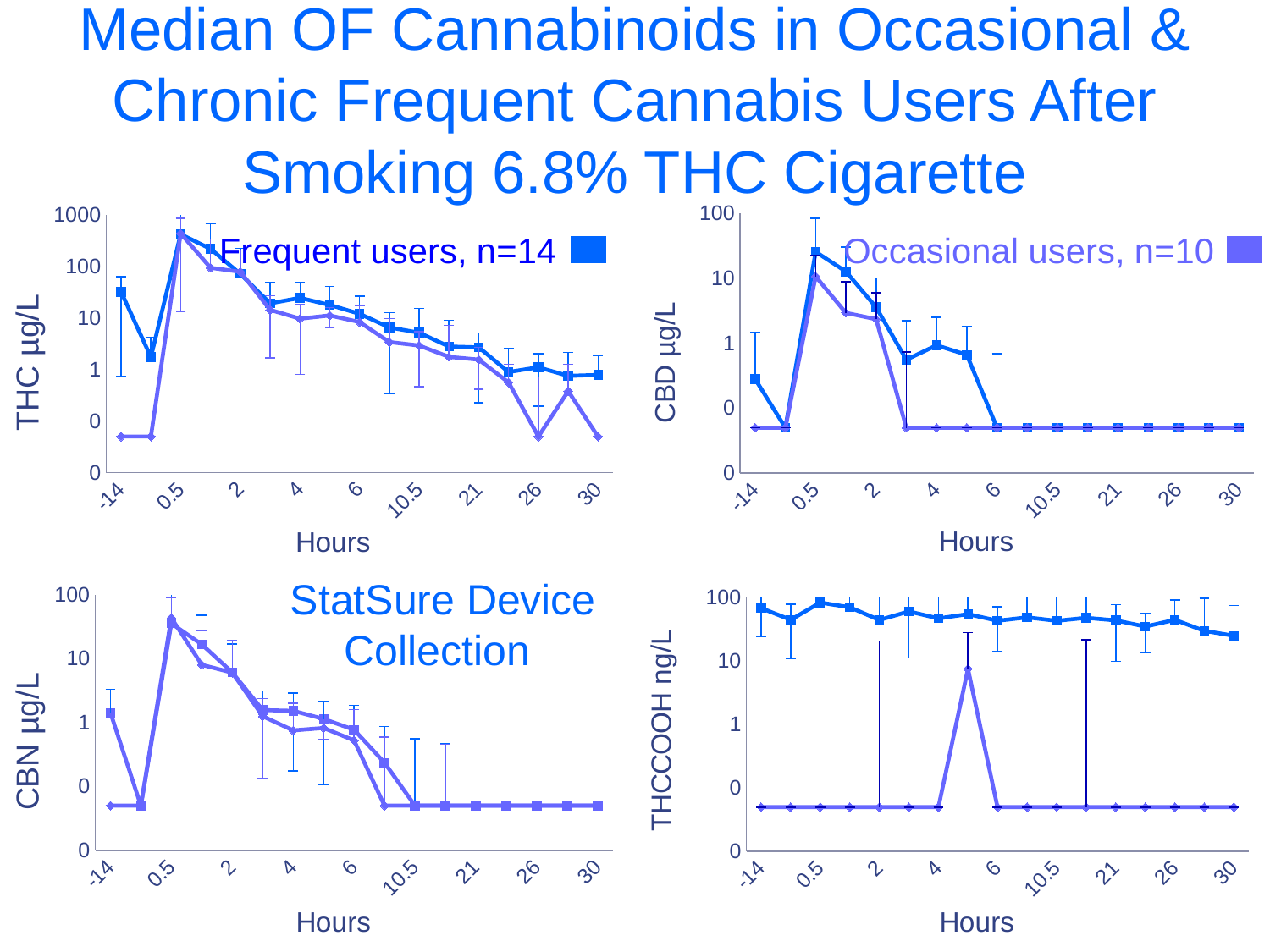
How many charts are shown on the slide? 4 What is the y-axis label of the bottom-right chart? THCCOOH ng/L In the THC µg/L chart (top left), which series has the larger value at -14 hours, frequent users or occasional users? Frequent users How many series does the legend list? 2 In the CBD µg/L chart (top right), which series has the larger value at 4 hours, frequent users or occasional users? Frequent users In the legend, how many frequent users are there (n)? 14 What kind of chart is the THC µg/L chart (top left)? line chart In the THCCOOH ng/L chart (bottom right), is the value for frequent users at 30 hours greater or less than 10? greater In the CBD µg/L chart (top right), is the value for frequent users at 0.5 hours greater or less than 10? greater In the CBN µg/L chart (bottom left), is the value for frequent users at 0.5 hours greater or less than 10? greater In the THC µg/L chart (top left), do the frequent users' values rise or fall from 0.5 hours to 30 hours? fall